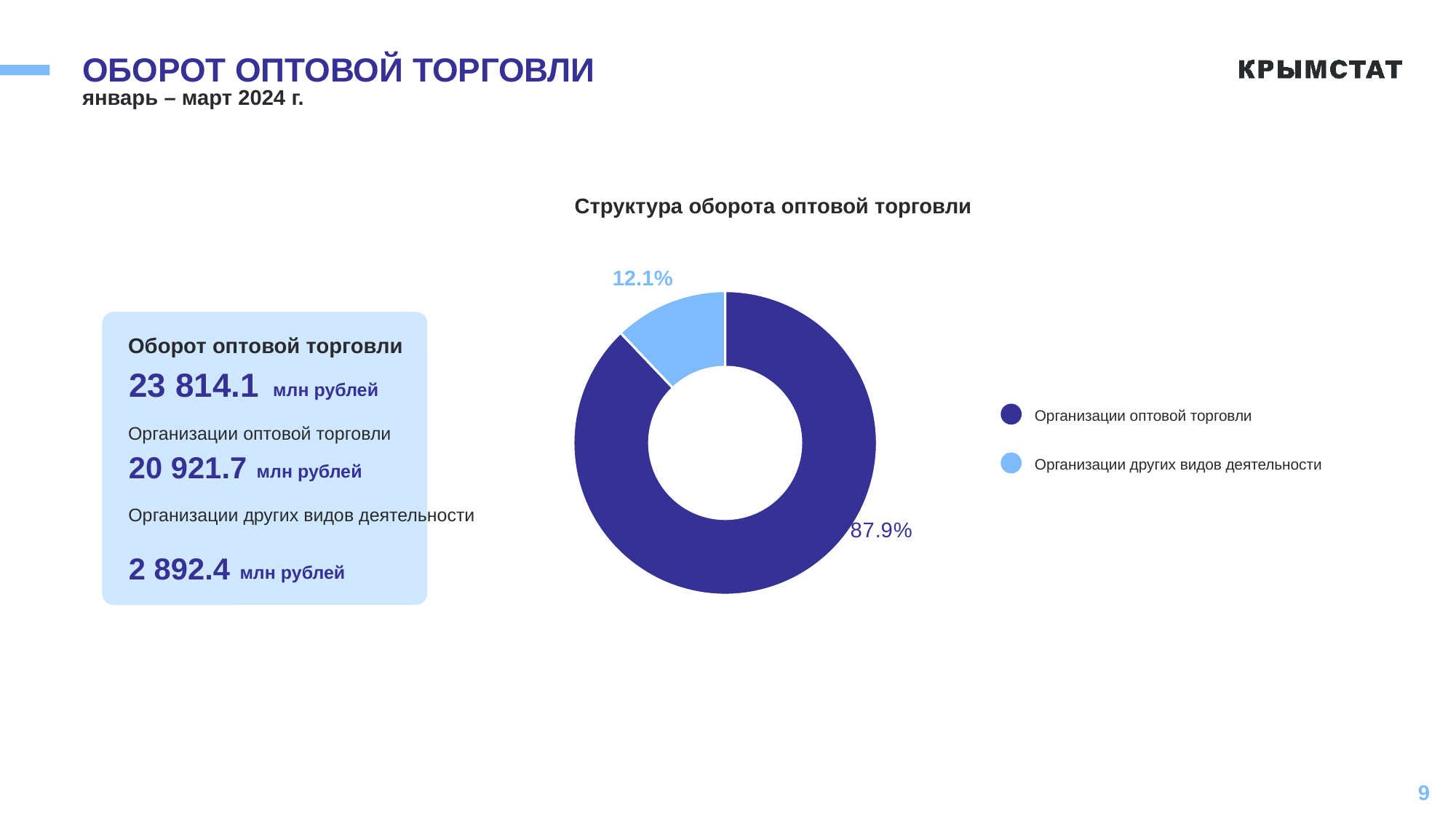
Which category has the smallest share in the chart 'Структура оборота оптовой торговли'? Организации других видов деятельности What type of chart is used to show 'Структура оборота оптовой торговли'? Pie chart (donut) Which has a larger share: Организации оптовой торговли or Организации других видов деятельности? Организации оптовой торговли What is the difference in percentage points between the shares of Организации оптовой торговли and Организации других видов деятельности? 75.8 How many entries does the legend of the chart list? 2 Is the share for Организации оптовой торговли greater or less than 50%? greater Which category has the largest share in the chart 'Структура оборота оптовой торговли'? Организации оптовой торговли What share of the wholesale trade turnover structure is attributed to Организации других видов деятельности? 12.1% What is the title of the chart on the slide? Структура оборота оптовой торговли How many categories are shown in the chart 'Структура оборота оптовой торговли'? 2 What share of the wholesale trade turnover structure is attributed to Организации оптовой торговли? 87.9% What colour represents Организации других видов деятельности in the chart? Light blue